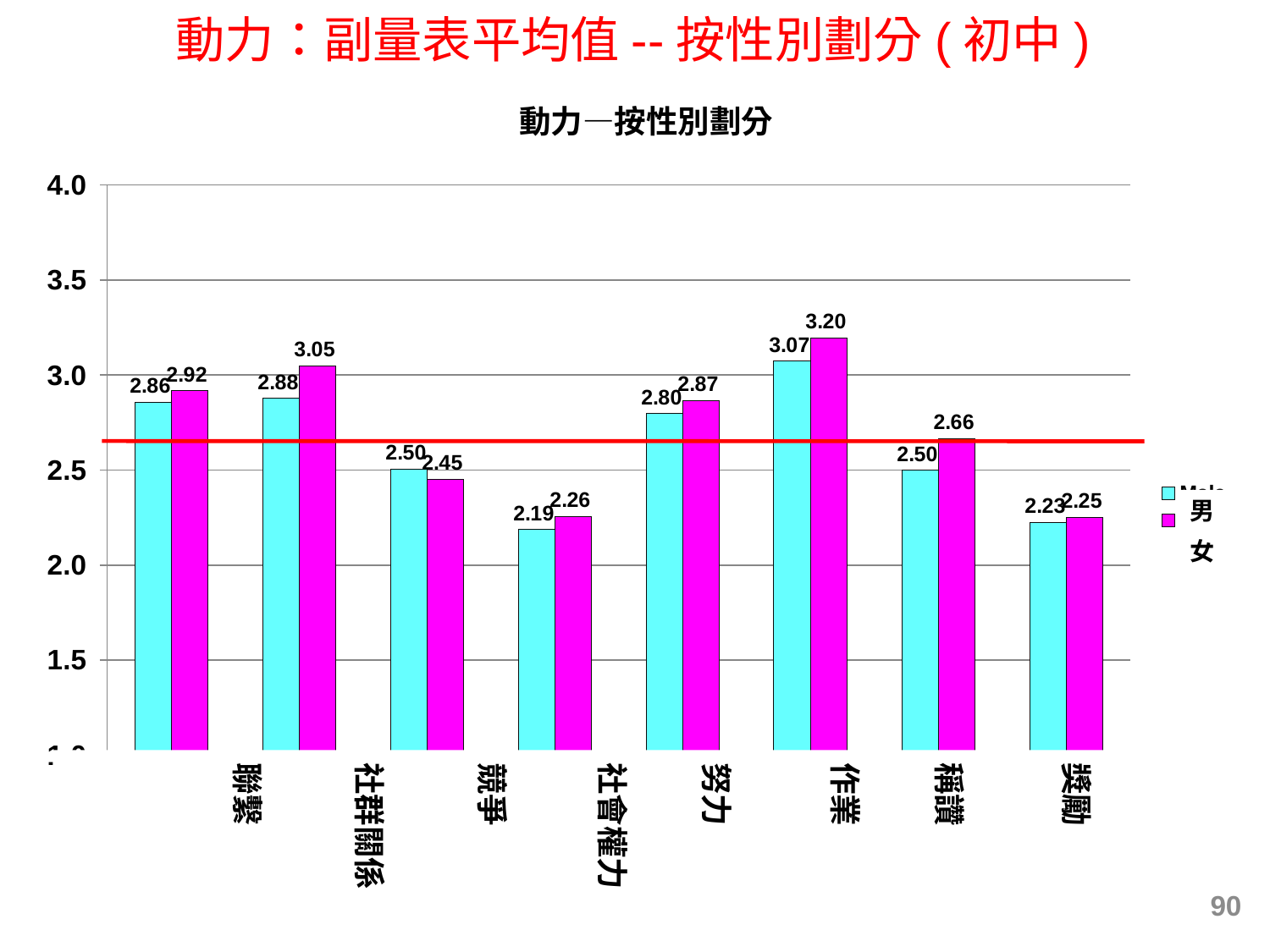
How many categories are shown on the x axis? 8 What is the value for 男 in the 作業 category? 3.07 What is the value for 男 in the 社會權力 category? 2.19 What is the value for 女 in the 社群關係 category? 3.05 Which category has the highest value for 女? 作業 In the 競爭 category, which is larger, the 男 value or the 女 value? 男 What is the difference between the 女 and 男 values in the 稱讚 category? 0.16 Is the value for 女 in the 努力 category greater or less than 2.5? greater What is the difference between the 女 and 男 values in the 作業 category? 0.13 Which category has the lowest value for 男? 社會權力 What kind of chart is this? bar chart What is the title of the chart? 動力─按性別劃分